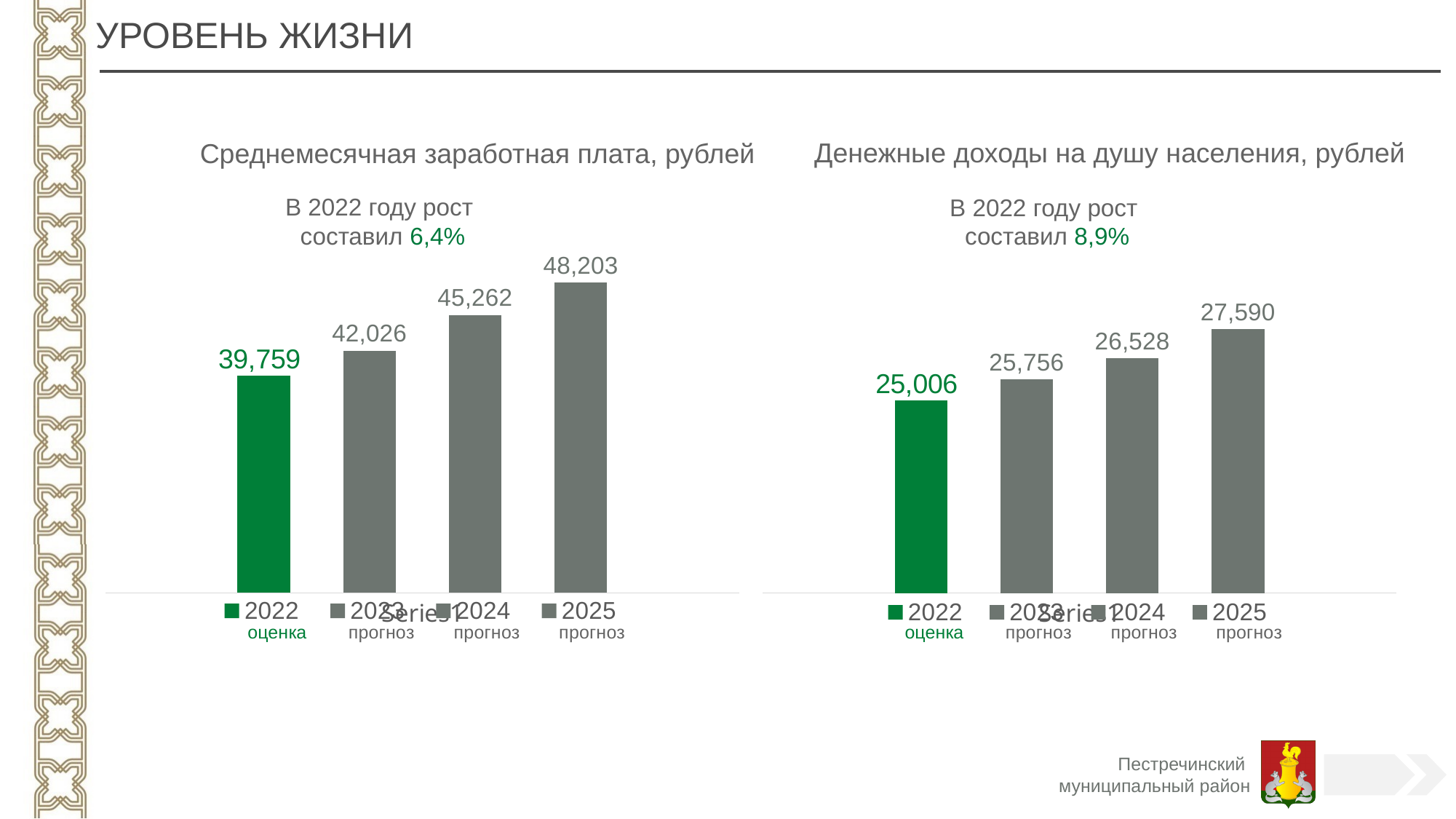
In the chart titled "Денежные доходы на душу населения, рублей", what is the difference between the 2025 and 2024 values? 1,062 In the chart titled "Денежные доходы на душу населения, рублей", which year has the lowest value? 2022 In the chart titled "Среднемесячная заработная плата, рублей", what is the difference between the 2025 and 2022 values? 8,444 In the chart titled "Среднемесячная заработная плата, рублей", what is the value for 2022? 39,759 In the chart titled "Среднемесячная заработная плата, рублей", which year has the highest value? 2025 In the chart titled "Среднемесячная заработная плата, рублей", which is larger, the value for 2023 or the value for 2024? 2024 In the chart titled "Среднемесячная заработная плата, рублей", what is the value for 2025? 48,203 How many bars are plotted in the chart titled "Денежные доходы на душу населения, рублей"? 4 In the chart titled "Денежные доходы на душу населения, рублей", what is the value for 2023? 25,756 In the chart titled "Денежные доходы на душу населения, рублей", do the values rise or fall from 2022 to 2025? rise In the chart titled "Денежные доходы на душу населения, рублей", what is the value for 2024? 26,528 What kind of chart is the chart titled "Среднемесячная заработная плата, рублей"? bar chart